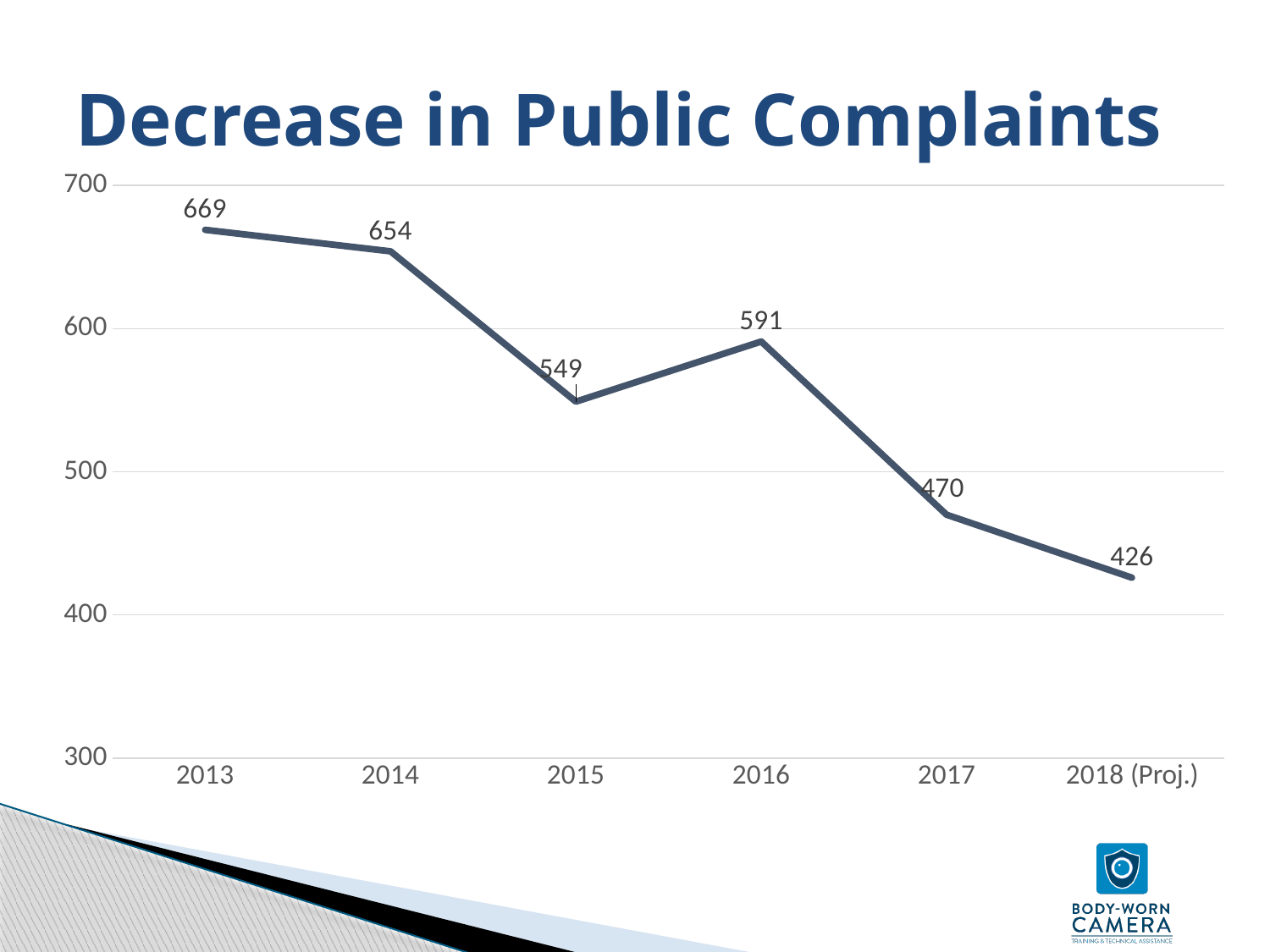
Which year has the lowest value? 2018 (Proj.) How many years are plotted on the chart? 6 What is the value for 2013? 669 What is the difference between the values for 2013 and 2018 (Proj.)? 243 What kind of chart is shown on the slide? line chart Is the value for 2017 greater or less than 500? less Which year has the highest value? 2013 Which is larger, the value for 2015 or the value for 2016? 2016 What is the projected value for 2018 (Proj.)? 426 What is the difference between the values for 2016 and 2017? 121 What is the value for 2016? 591 What is the title of the chart? Decrease in Public Complaints